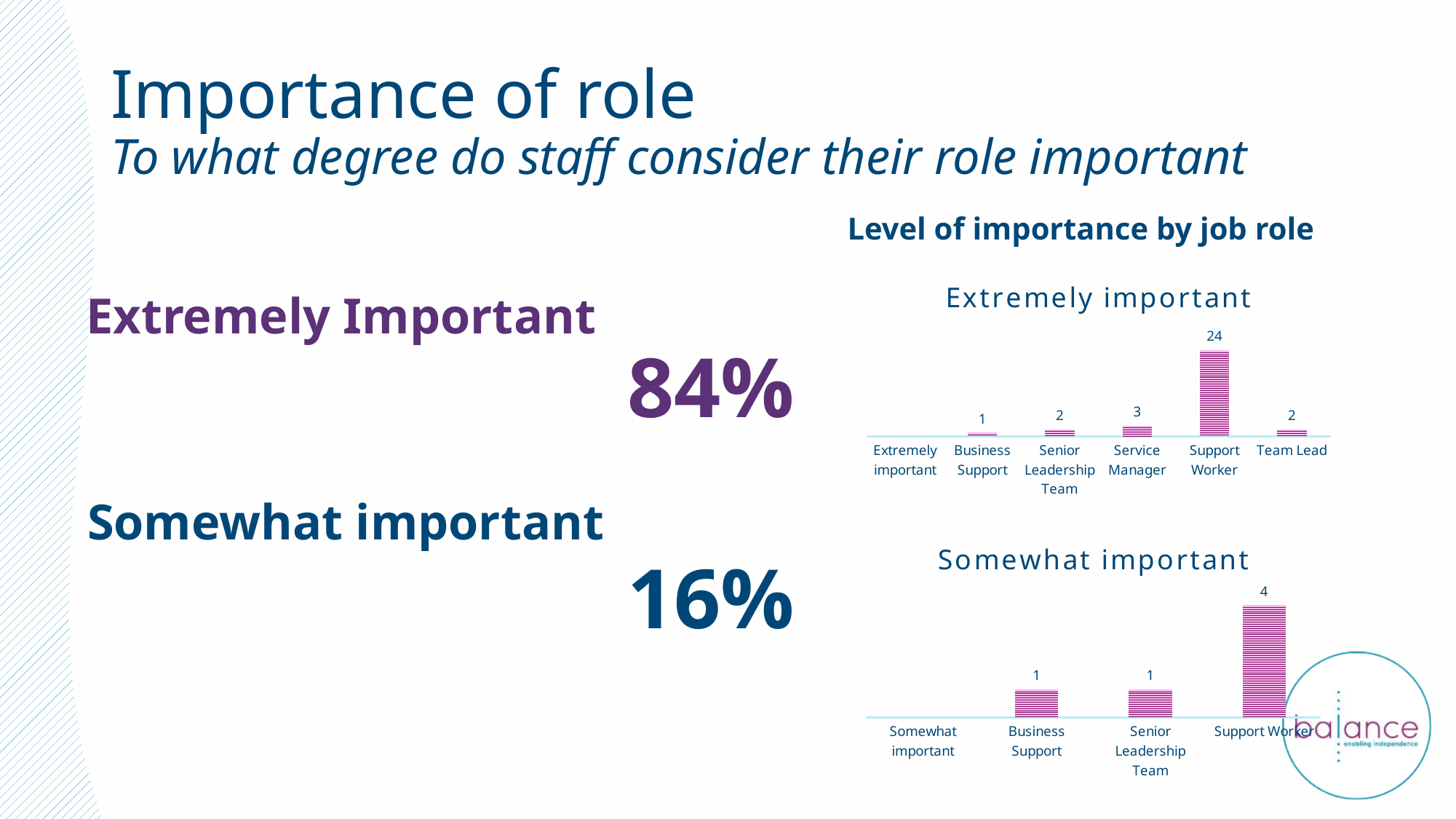
In the 'Somewhat important' chart, what is the value for Senior Leadership Team? 1 In the 'Somewhat important' chart, what is the difference between Support Worker and Business Support? 3 In the 'Somewhat important' chart, which job role has the highest value? Support Worker In the 'Somewhat important' chart, what is the value for Support Worker? 4 In the 'Extremely important' chart, which job role has the highest value? Support Worker In the 'Extremely important' chart, what is the value for Service Manager? 3 In the 'Extremely important' chart, what is the value for Support Worker? 24 What type of chart is the 'Extremely important' chart? Bar chart In the 'Extremely important' chart, what is the difference between Support Worker and Service Manager? 21 In the 'Extremely important' chart, what is the value for Team Lead? 2 In the 'Extremely important' chart, what is the value for Business Support? 1 In the 'Extremely important' chart, which job role has the lowest value? Business Support